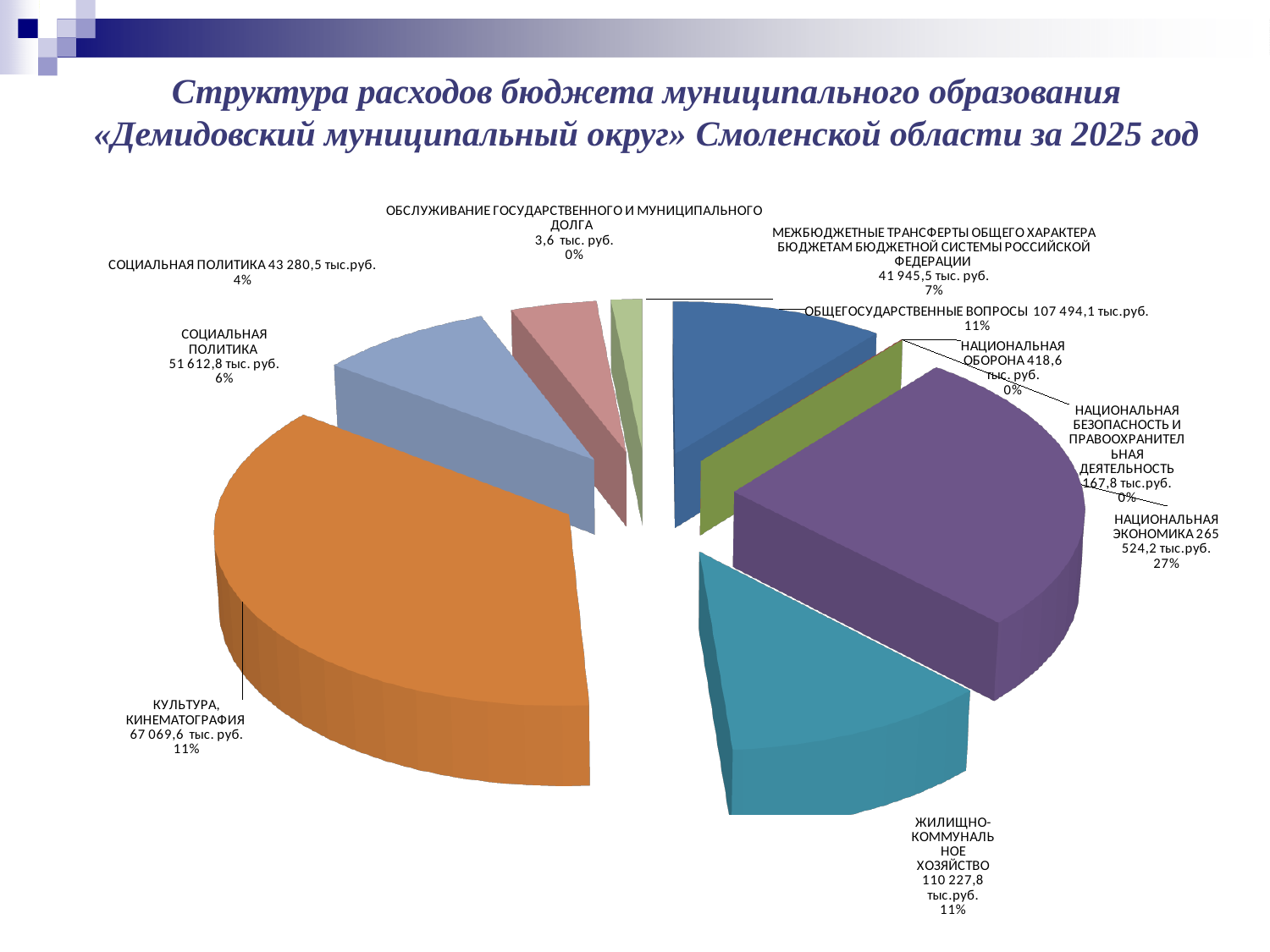
What year does the chart title say the budget expenditure structure is for? 2025 How many slices (categories) does the pie chart have? 10 Which is larger: the value for ОБЩЕГОСУДАРСТВЕННЫЕ ВОПРОСЫ or for КУЛЬТУРА, КИНЕМАТОГРАФИЯ? ОБЩЕГОСУДАРСТВЕННЫЕ ВОПРОСЫ What is the difference between the values for НАЦИОНАЛЬНАЯ ЭКОНОМИКА and ЖИЛИЩНО-КОММУНАЛЬНОЕ ХОЗЯЙСТВО? 155 296,4 тыс.руб. What is the value shown for ЖИЛИЩНО-КОММУНАЛЬНОЕ ХОЗЯЙСТВО? 110 227,8 тыс.руб. What is the value shown for НАЦИОНАЛЬНАЯ ЭКОНОМИКА? 265 524,2 тыс.руб. What is the value shown for КУЛЬТУРА, КИНЕМАТОГРАФИЯ? 67 069,6 тыс. руб. What kind of chart is shown on the slide? Pie chart Which category has the smallest value in the pie chart? ОБСЛУЖИВАНИЕ ГОСУДАРСТВЕННОГО И МУНИЦИПАЛЬНОГО ДОЛГА What percentage share of the pie does НАЦИОНАЛЬНАЯ ЭКОНОМИКА have? 27% What is the value shown for МЕЖБЮДЖЕТНЫЕ ТРАНСФЕРТЫ ОБЩЕГО ХАРАКТЕРА БЮДЖЕТАМ БЮДЖЕТНОЙ СИСТЕМЫ РОССИЙСКОЙ ФЕДЕРАЦИИ? 41 945,5 тыс. руб.